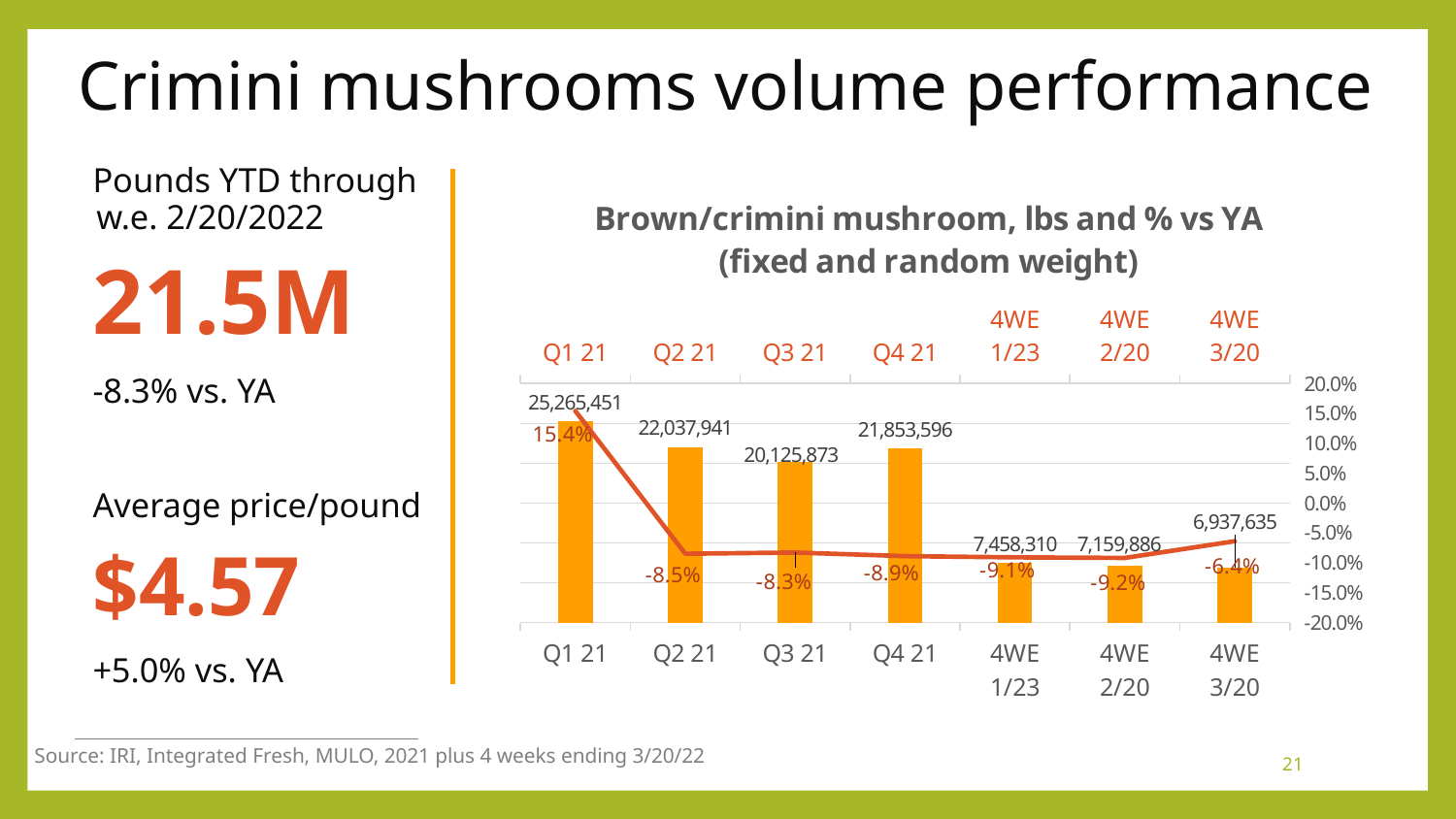
Which period has the highest pounds value? Q1 21 What is the difference in pounds between Q2 21 and Q3 21? 1,912,068 Which period has the lowest pounds value? 4WE 3/20 Do the pounds values for the three 4WE periods rise or fall from 1/23 to 3/20? fall What is the % vs YA value for the 4WE 2/20 period? -9.2% What is the pounds value for Q1 21? 25,265,451 How many periods are shown on the x axis? 7 Which period is the only one with a positive % vs YA value? Q1 21 Which has a larger pounds value, Q4 21 or Q3 21? Q4 21 What is the % vs YA value for Q2 21? -8.5% What is the title of the chart? Brown/crimini mushroom, lbs and % vs YA (fixed and random weight) What is the pounds value for the 4WE 3/20 period? 6,937,635